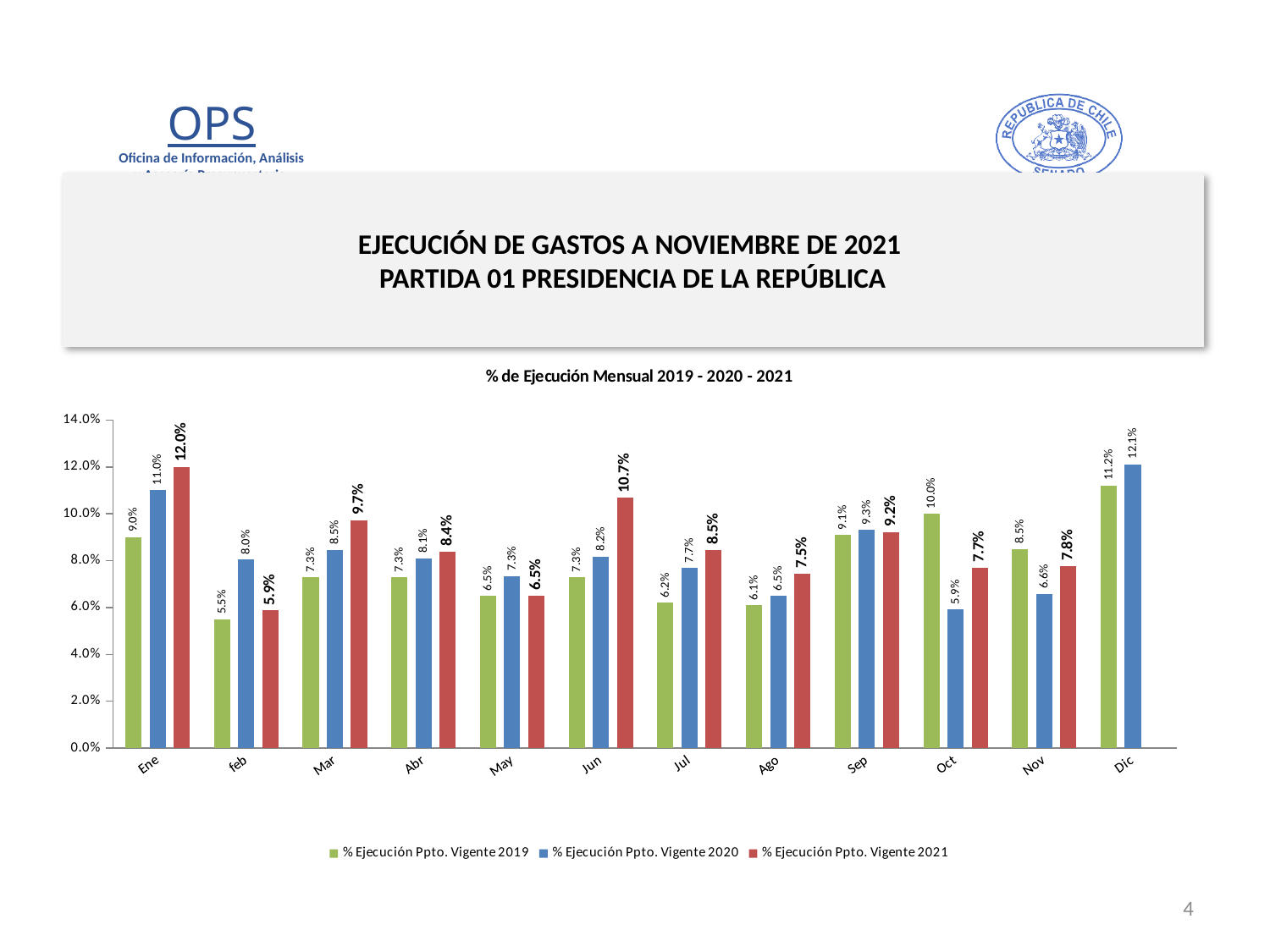
What is the value for % Ejecución Ppto. Vigente 2019 in Dic? 11.2% Which month has no bar for % Ejecución Ppto. Vigente 2021? Dic In which month is the % Ejecución Ppto. Vigente 2019 value lowest? feb What is the value for % Ejecución Ppto. Vigente 2020 in Oct? 5.9% How many months are shown on the x axis? 12 Which is larger in Oct: the 2019 value or the 2021 value? 2019 value What is the title of the chart? % de Ejecución Mensual 2019 - 2020 - 2021 How many series does the legend list? 3 What is the difference between the 2021 and 2019 values in Jun? 3.4% What is the value for % Ejecución Ppto. Vigente 2021 in Ene? 12.0% What kind of chart is shown? Bar chart In which month is the % Ejecución Ppto. Vigente 2021 value highest? Ene